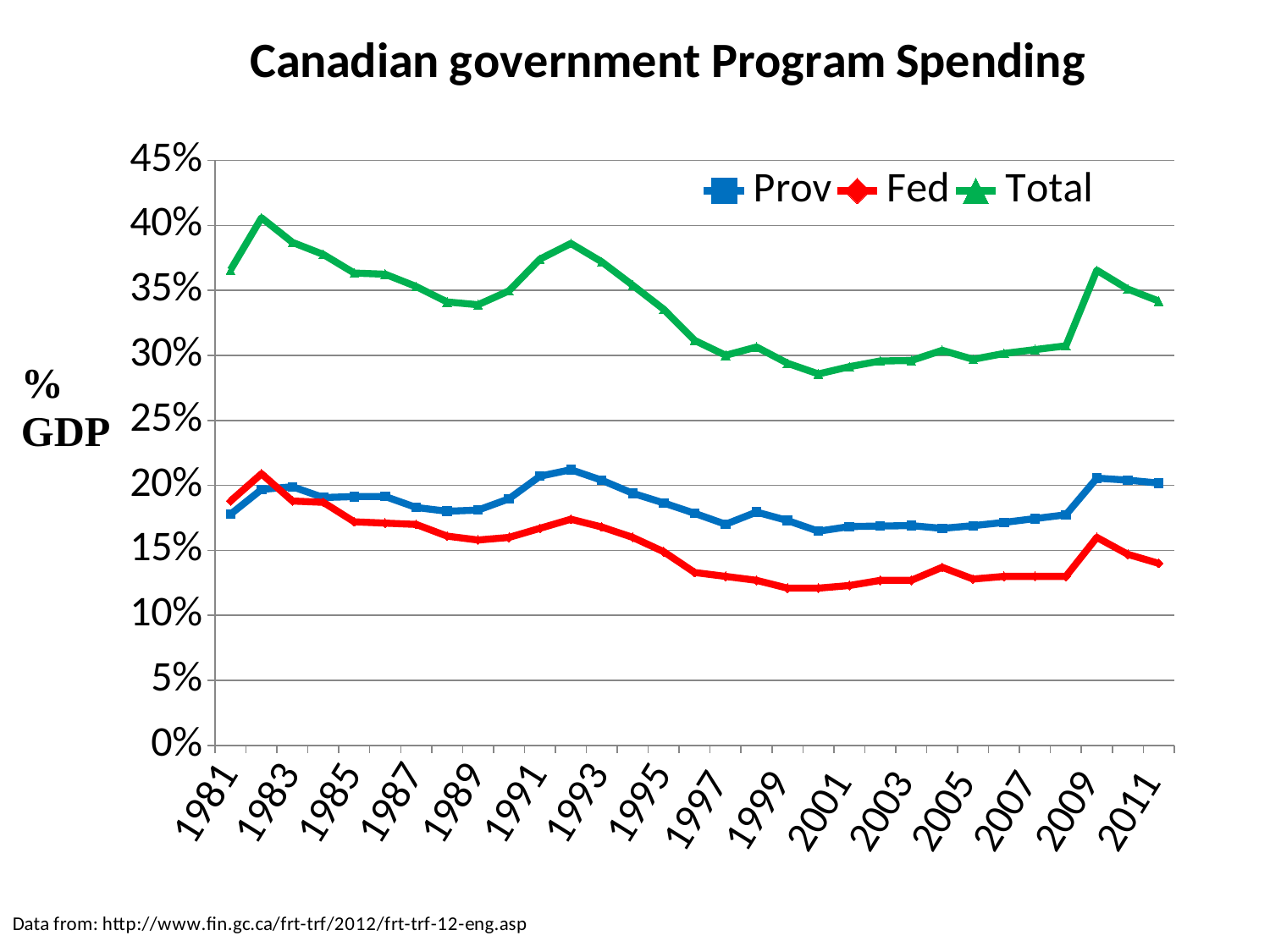
Which series has the highest values across the whole chart? Total Is the value for Prov in 1992 greater or less than 20%? greater How many series does the legend list? 3 Is the value for Total in 1981 greater or less than 35%? greater Which is larger in 2011, the Prov value or the Fed value? Prov In which year does the Total series reach its highest value? 1982 Does the Total series rise or fall between 1992 and 2000? fall Is the value for Total in 2000 greater or less than 30%? less What kind of chart is shown on the slide? line chart How many year labels are shown on the x axis? 16 What is the title of the chart? Canadian government Program Spending